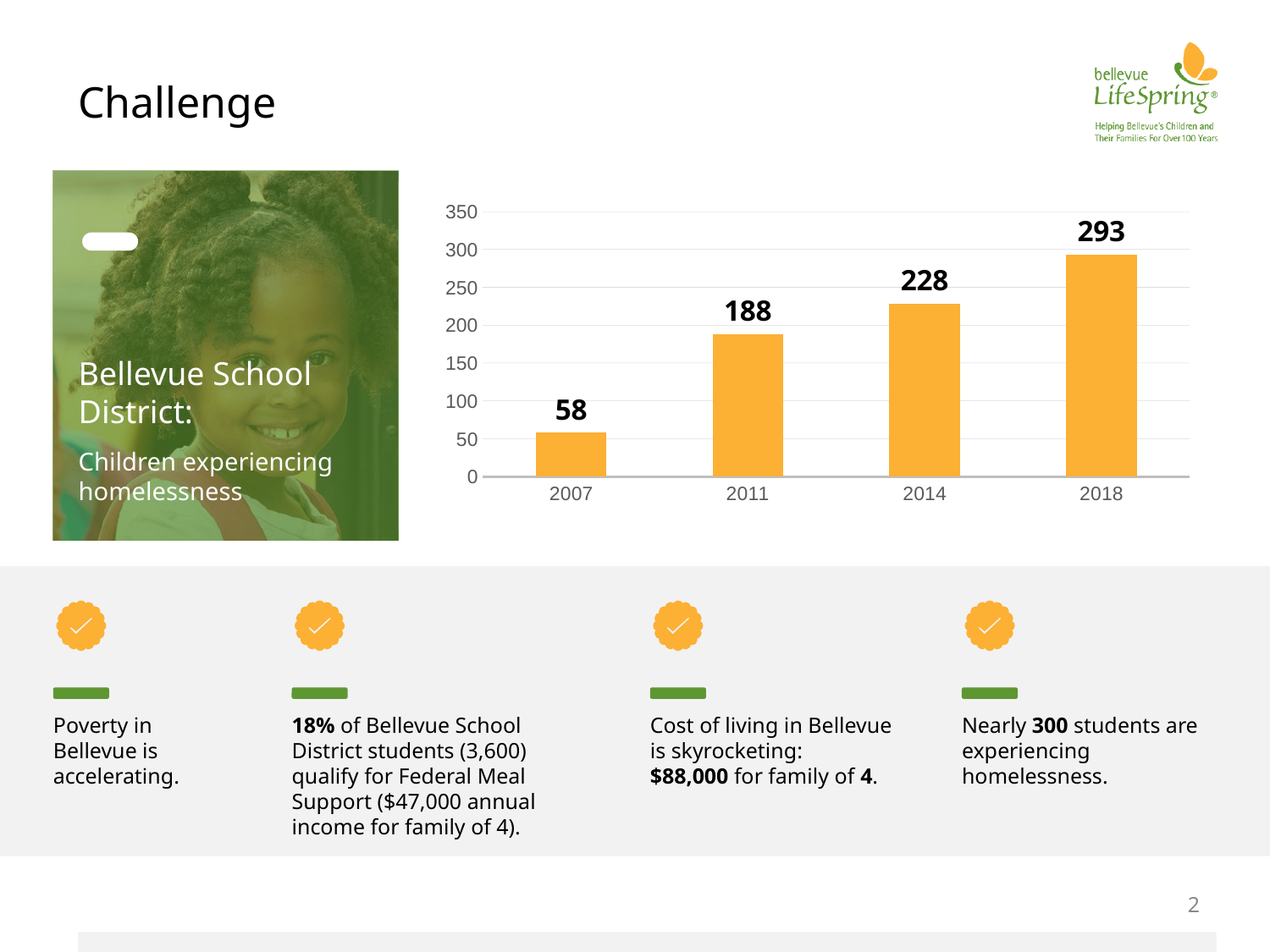
How many years are shown on the x axis? 4 What is the value for 2014? 228 Which year has the lowest value? 2007 What kind of chart is shown? bar chart What is the value for 2007? 58 What is the value for 2018? 293 What is the difference between the values for 2014 and 2011? 40 What is the value for 2011? 188 Which is larger, the value for 2011 or the value for 2014? 2014 Do the values rise or fall from 2007 to 2018? rise What is the difference between the values for 2018 and 2007? 235 Which year has the highest value? 2018